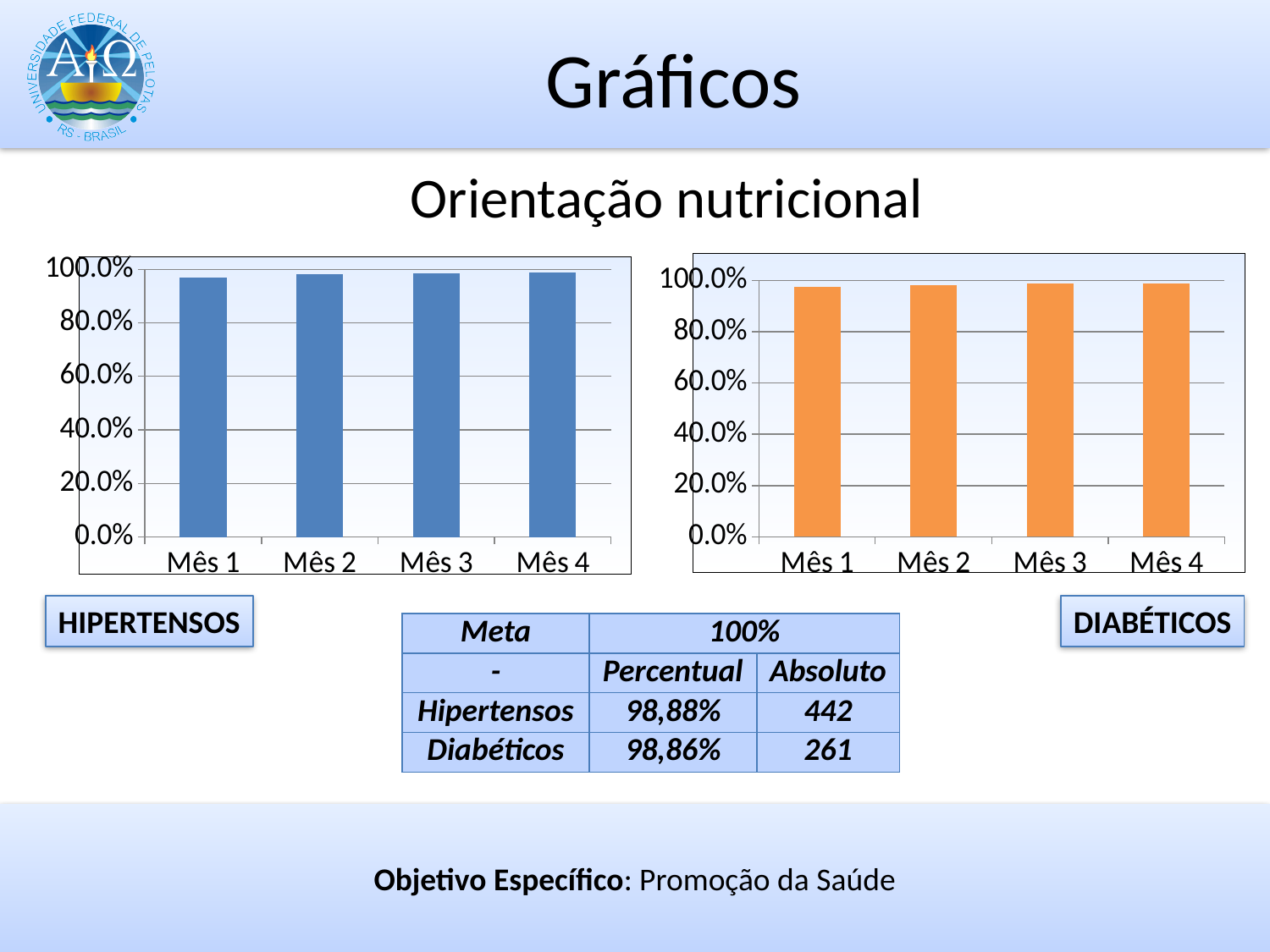
What kind of chart is the HIPERTENSOS chart on the left? bar chart In the HIPERTENSOS chart on the left, is the value for Mês 1 greater or less than 80.0%? greater How many categories are shown on the x axis of the HIPERTENSOS chart on the left? 4 In the DIABÉTICOS chart on the right, is the value for Mês 2 greater or less than 80.0%? greater What kind of chart is the DIABÉTICOS chart on the right? bar chart How many categories are shown on the x axis of the DIABÉTICOS chart on the right? 4 In the HIPERTENSOS chart on the left, is the value for Mês 4 greater or less than 60.0%? greater What is the label of the first category on the x axis of the HIPERTENSOS chart on the left? Mês 1 What colour are the bars in the DIABÉTICOS chart on the right? orange